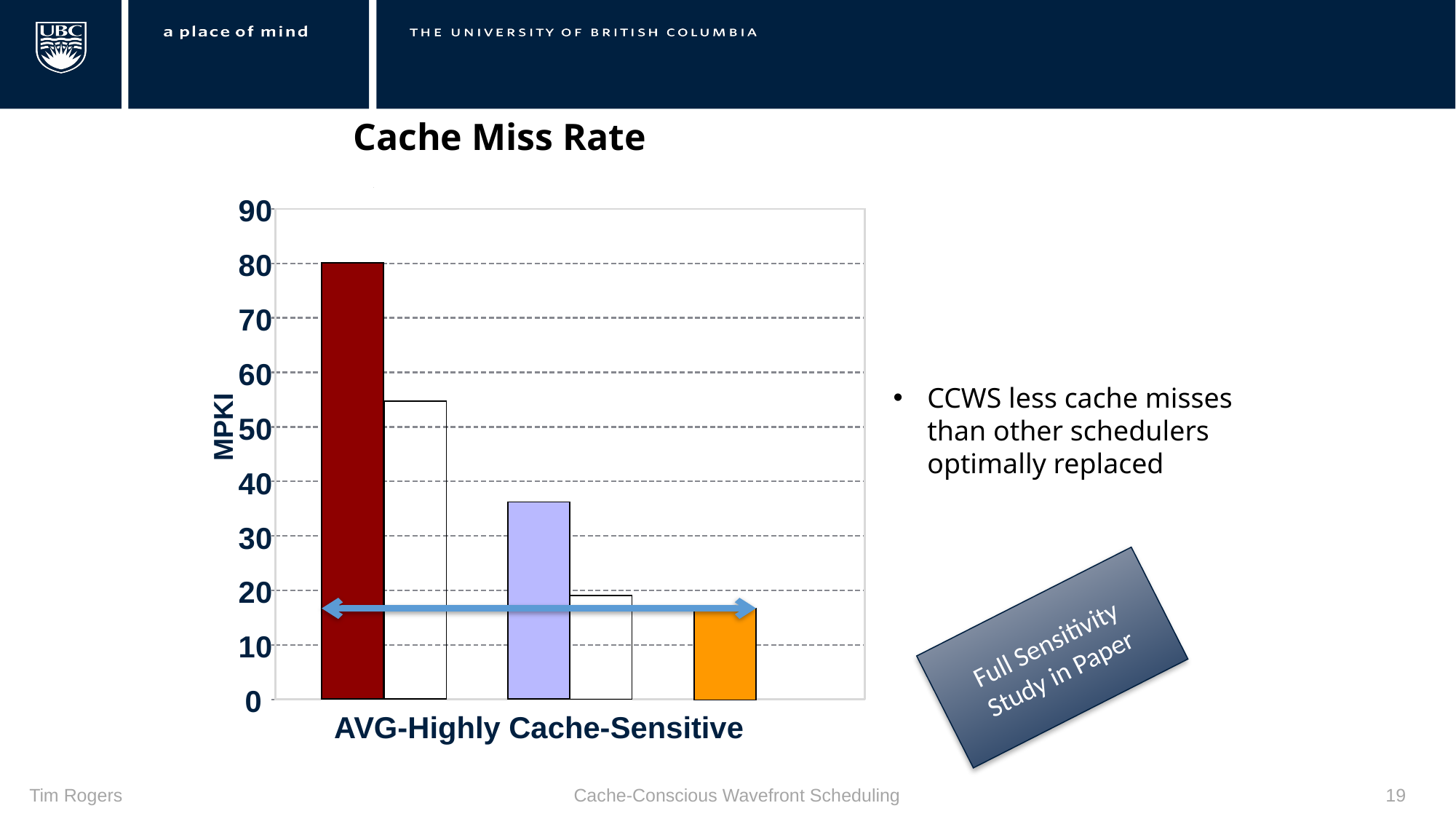
What is the label on the y axis of the chart? MPKI How many bars are plotted in the chart? 5 Is the value of the first white bar (second from left) greater or less than 50? greater Which bar has the highest value in the chart? The dark red (leftmost) bar Which bar has the lowest value in the chart? The orange (rightmost) bar What is the category label shown on the x axis of the chart? AVG-Highly Cache-Sensitive What is the title of the chart on the slide? Cache Miss Rate Which is larger, the dark red bar or the light purple bar? The dark red bar What is the MPKI value of the dark red (leftmost) bar? 80 Is the value of the orange (rightmost) bar greater or less than 20? less What kind of chart is shown on the slide? Bar chart Is the value of the light purple bar greater or less than 40? less